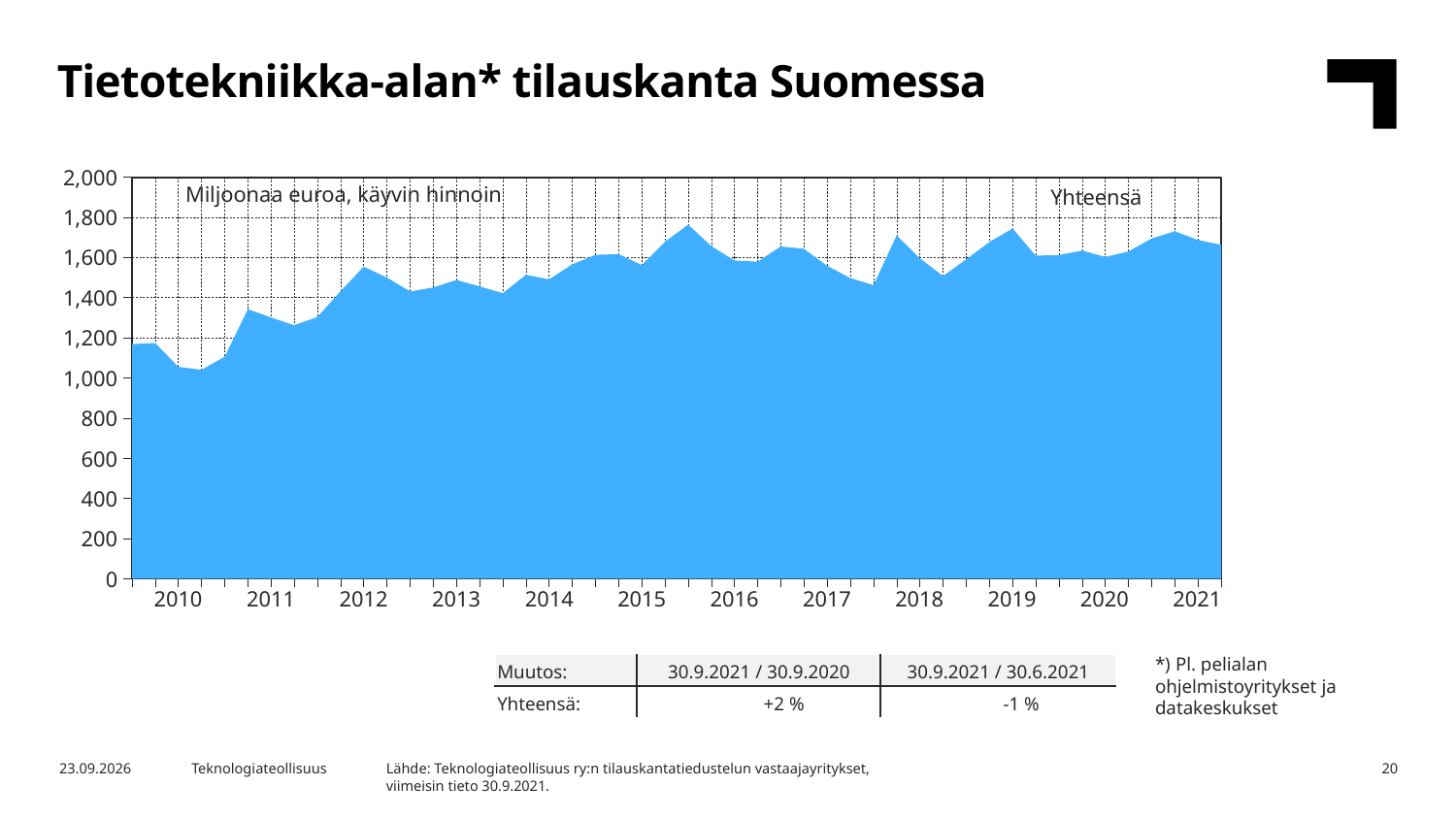
Is the value at the end of 2021 greater or less than 1,400? greater Is the value at the start of 2010 greater or less than 1,000? greater Is the peak value in 2015 greater or less than 1,600? greater Overall, does the order backlog rise or fall from 2010 to 2021? rise What is the title of the chart on the slide? Tietotekniikka-alan* tilauskanta Suomessa What is the name of the series plotted in the chart? Yhteensä What is the highest value shown on the y axis of the chart? 2,000 What kind of chart is shown on the slide? Area chart How many series does the chart show? 1 How many year labels are shown on the x axis of the chart? 12 Which year has a lower order backlog, 2010 or 2019? 2010